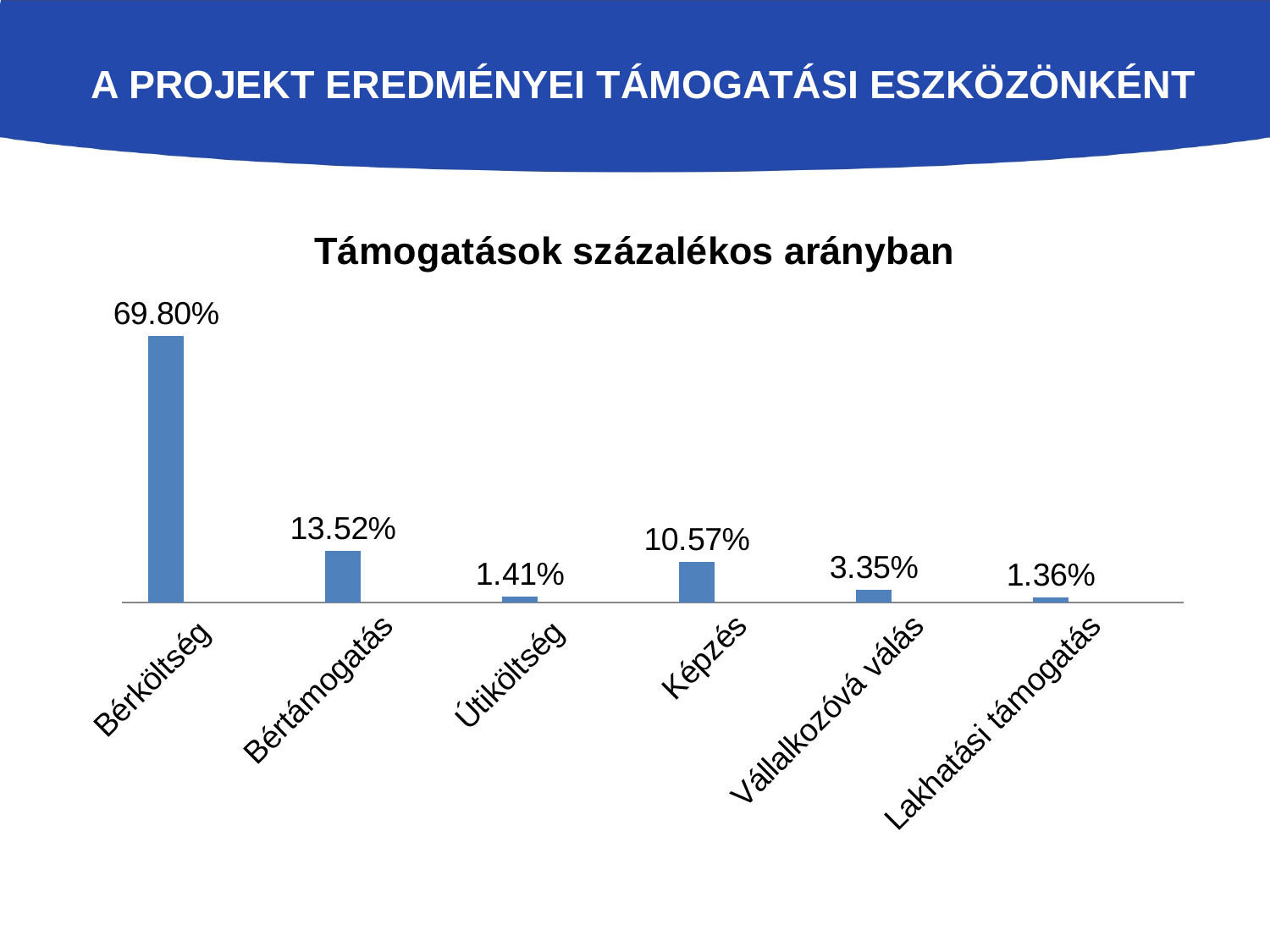
What is the value for Bérköltség? 69.80% Which is larger, the value for Útiköltség or the value for Vállalkozóvá válás? Vállalkozóvá válás What is the value for Vállalkozóvá válás? 3.35% What is the value for Képzés? 10.57% What kind of chart is shown on the slide? Bar chart Which category has the highest value? Bérköltség Which category has the lowest value? Lakhatási támogatás How many categories are shown in the chart? 6 What is the value for Lakhatási támogatás? 1.36% What is the difference between the values for Bérköltség and Bértámogatás? 56.28% What is the difference between the values for Bértámogatás and Képzés? 2.95% What is the title of the chart? Támogatások százalékos arányban